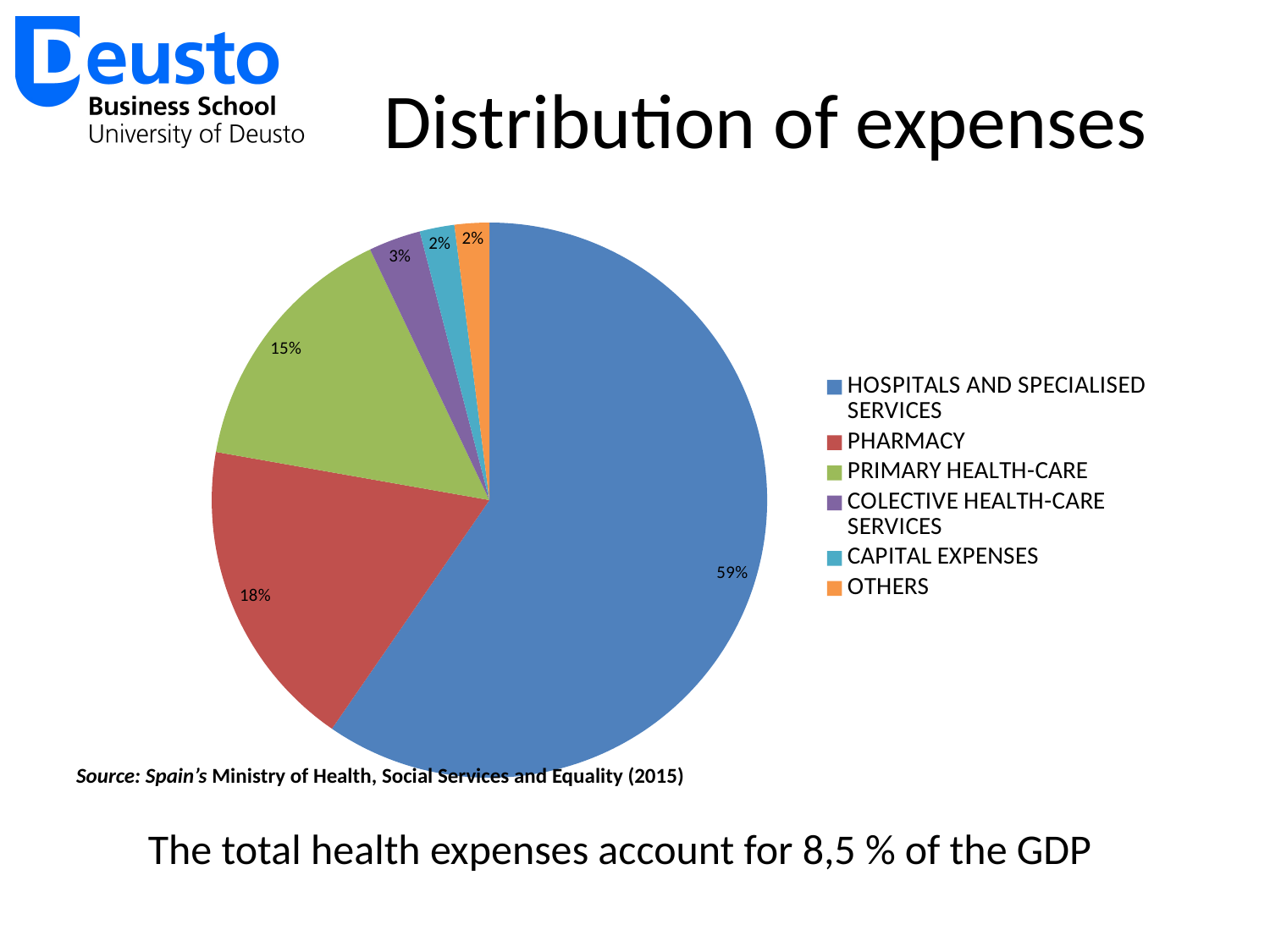
Which is larger, the share for PHARMACY or the share for PRIMARY HEALTH-CARE? PHARMACY How many categories does the pie chart show? 6 Which category has the largest share of expenses? HOSPITALS AND SPECIALISED SERVICES What share of expenses goes to CAPITAL EXPENSES? 2% What share of expenses goes to HOSPITALS AND SPECIALISED SERVICES? 59% What share of expenses goes to PRIMARY HEALTH-CARE? 15% What is the difference in percentage points between the PRIMARY HEALTH-CARE share and the COLECTIVE HEALTH-CARE SERVICES share? 12 What type of chart is shown on the slide? pie chart What is the title of the chart on the slide? Distribution of expenses What is the difference in percentage points between the HOSPITALS AND SPECIALISED SERVICES share and the PHARMACY share? 41